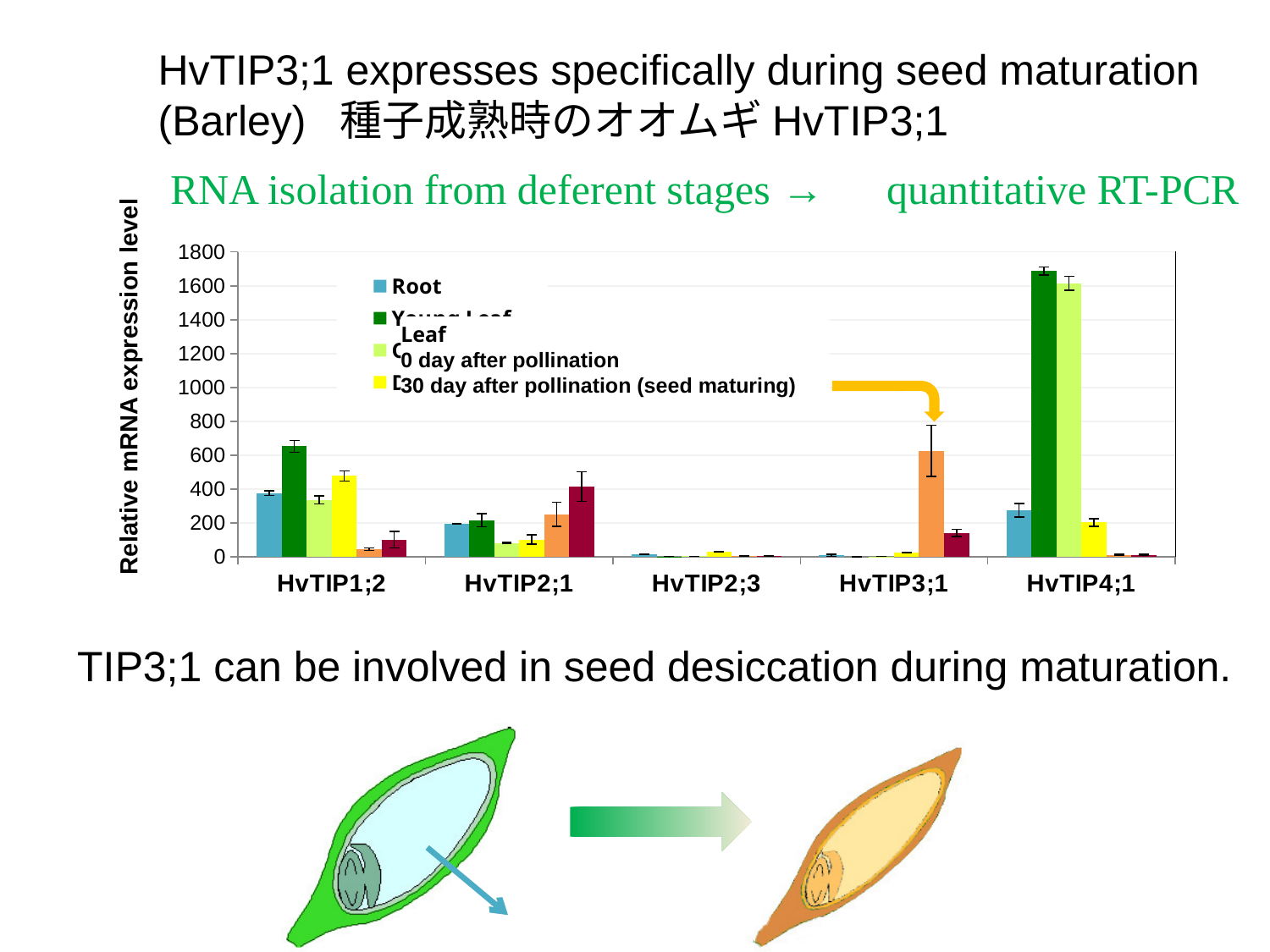
Is the tallest bar for HvTIP4;1 greater or less than 1600? greater Which gene category contains the tallest bar in the chart? HvTIP4;1 Which is larger: the dark green bar for HvTIP4;1 or the dark green bar for HvTIP1;2? HvTIP4;1 Is the tallest bar for HvTIP3;1 greater or less than 800? less What kind of chart is shown on the slide? bar chart What is the label of the y axis of the chart? Relative mRNA expression level Are all the bars for HvTIP2;3 greater or less than 200? less How many gene categories are shown on the x axis of the chart? 5 Which gene category has the lowest expression across all its bars? HvTIP2;3 What is the first entry listed in the chart legend? Root